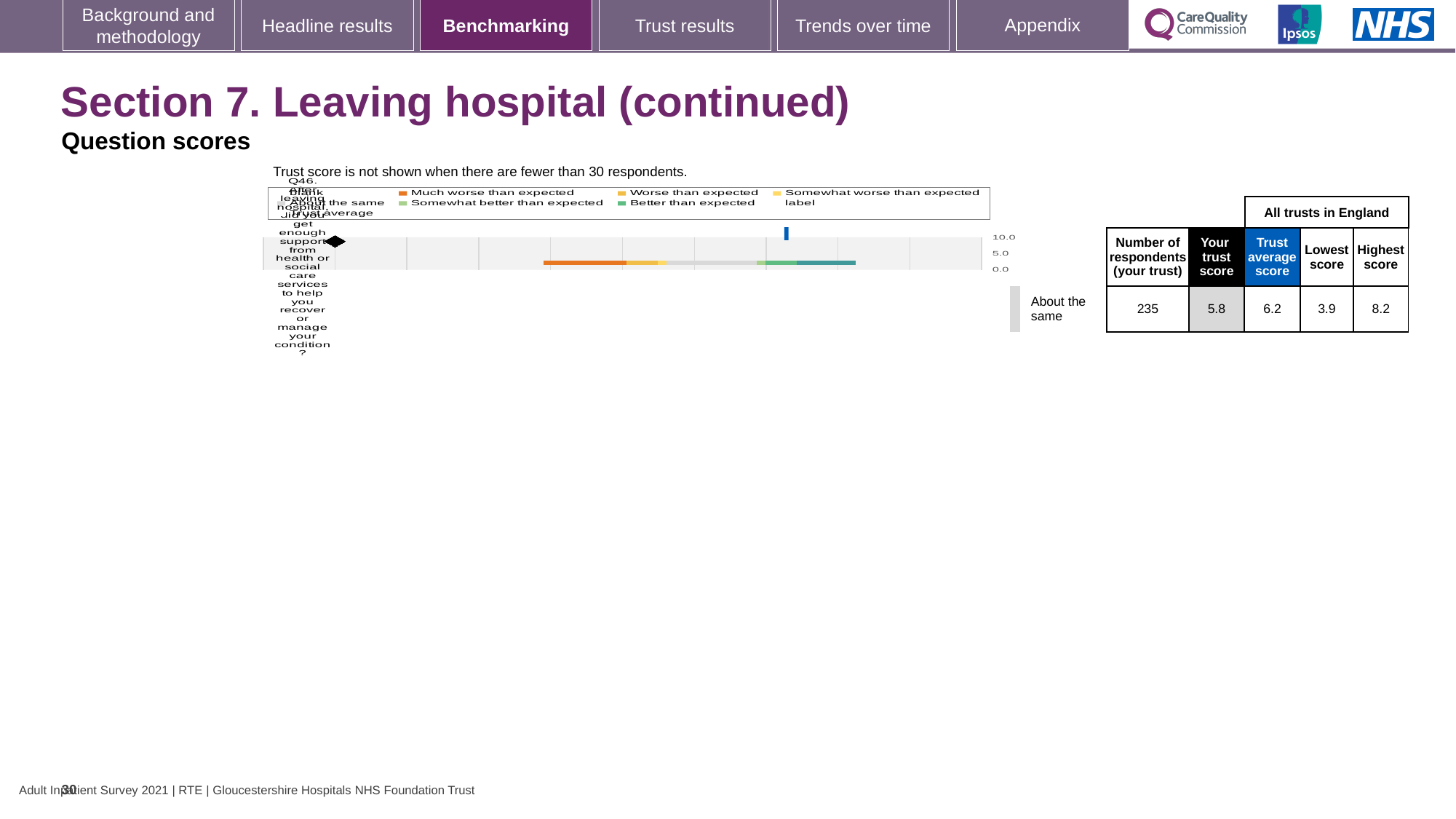
How many respondents from the trust answered Q46? 235 Which is larger for Q46: the trust score or the trust average score? Trust average score What is the trust average score for Q46? 6.2 Is the trust score for Q46 greater or less than 5.0 on the chart axis? greater What kind of chart is shown on the slide? bar chart What is the trust score for Q46 (support from health or social care services after leaving hospital)? 5.8 How many questions are plotted on the chart? 1 What is the highest score across all trusts in England for Q46? 8.2 What is the lowest score across all trusts in England for Q46? 3.9 What is the maximum value shown on the chart's axis? 10.0 What benchmark category is the trust's Q46 score placed in? About the same What is the difference between the highest and lowest scores for Q46 across all trusts in England? 4.3